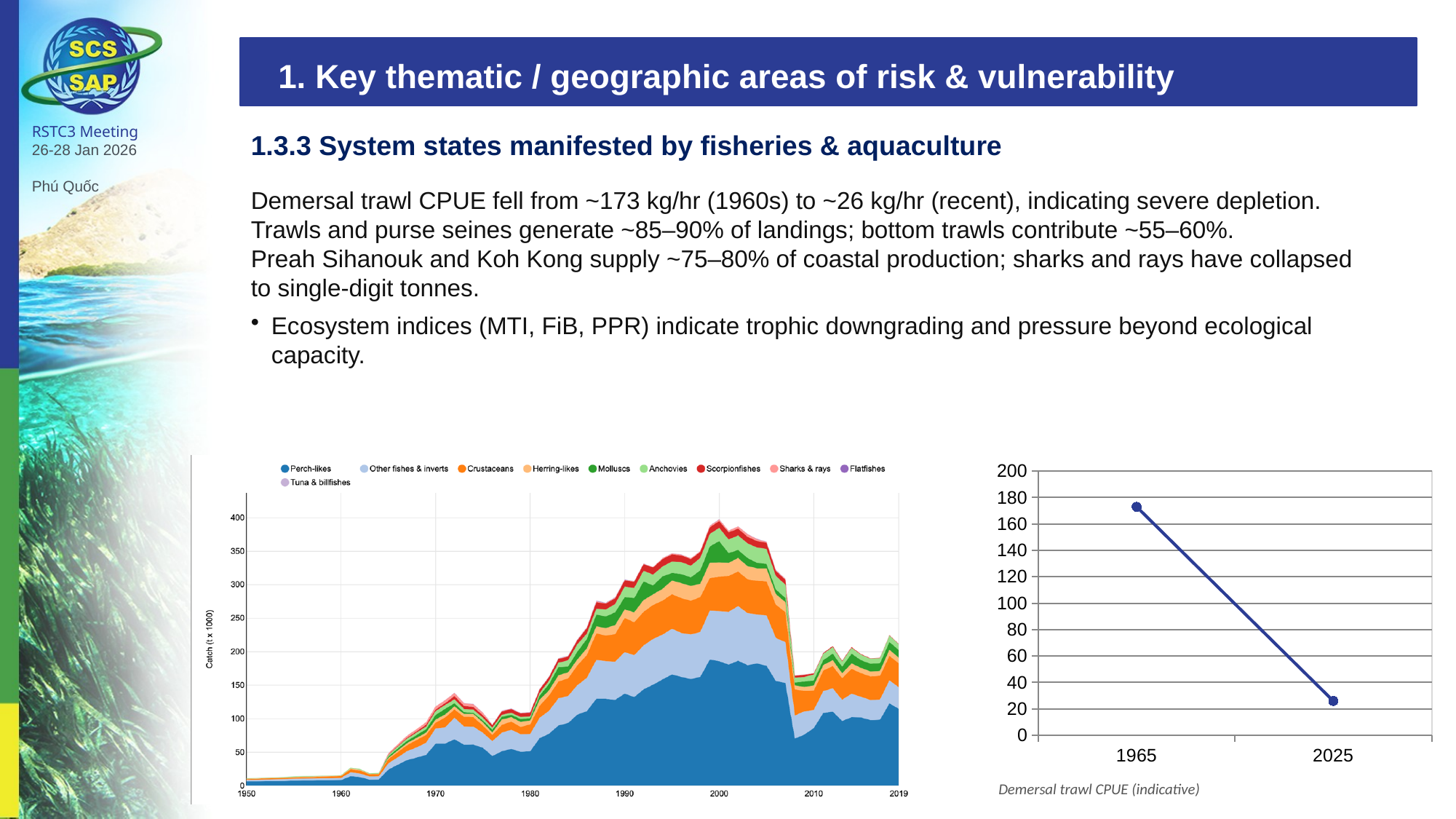
In the Demersal trawl CPUE chart on the right, what is the highest value shown on the vertical axis? 200 In the catch chart on the left, how many series does the legend list? 10 In the catch chart on the left, what is the label of the vertical axis? Catch (t x 1000) In the Demersal trawl CPUE chart on the right, does the value rise or fall from 1965 to 2025? fall In the catch chart on the left, is the total catch around the year 2000 greater or less than 350? greater In the catch chart on the left, which series contributes the largest share of the catch? Perch-likes What kind of chart is the catch chart on the left of the slide? stacked area chart In the Demersal trawl CPUE chart on the right, is the value for 1965 greater or less than 160? greater In the Demersal trawl CPUE chart on the right, how many data points are plotted? 2 In the Demersal trawl CPUE chart on the right, is the value for 2025 greater or less than 40? less In the Demersal trawl CPUE chart on the right, which year has the higher value, 1965 or 2025? 1965 What kind of chart is the chart on the right of the slide (Demersal trawl CPUE)? line chart